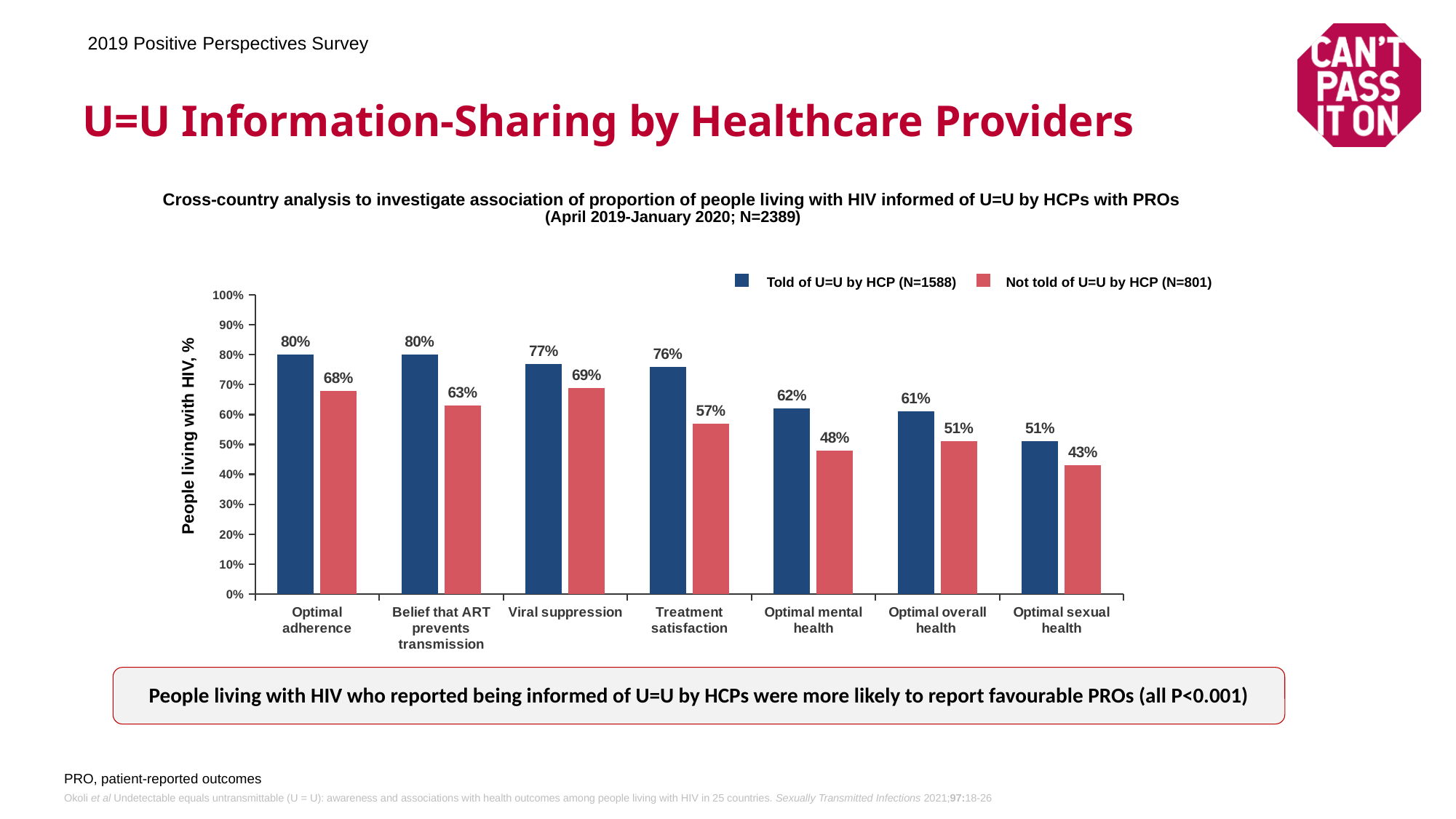
What kind of chart is shown on the slide? Bar chart What is the label of the y axis of the chart? People living with HIV, % Which category has the lowest value for the 'Not told of U=U by HCP' series? Optimal sexual health How many categories are shown on the x axis of the chart? 7 Which is larger: the 'Not told of U=U by HCP' value for viral suppression or for treatment satisfaction? Viral suppression What is the difference between the 'Told' and 'Not told' values for optimal mental health? 14% What is the value for 'Not told of U=U by HCP' for optimal mental health? 48% What is the value for 'Told of U=U by HCP' for treatment satisfaction? 76% What percentage of people told of U=U by HCP reported optimal adherence? 80% Is the 'Told of U=U by HCP' value for optimal sexual health greater or less than 60%? less What is the difference between the 'Told' and 'Not told' values for belief that ART prevents transmission? 17% How many series does the chart legend list? 2